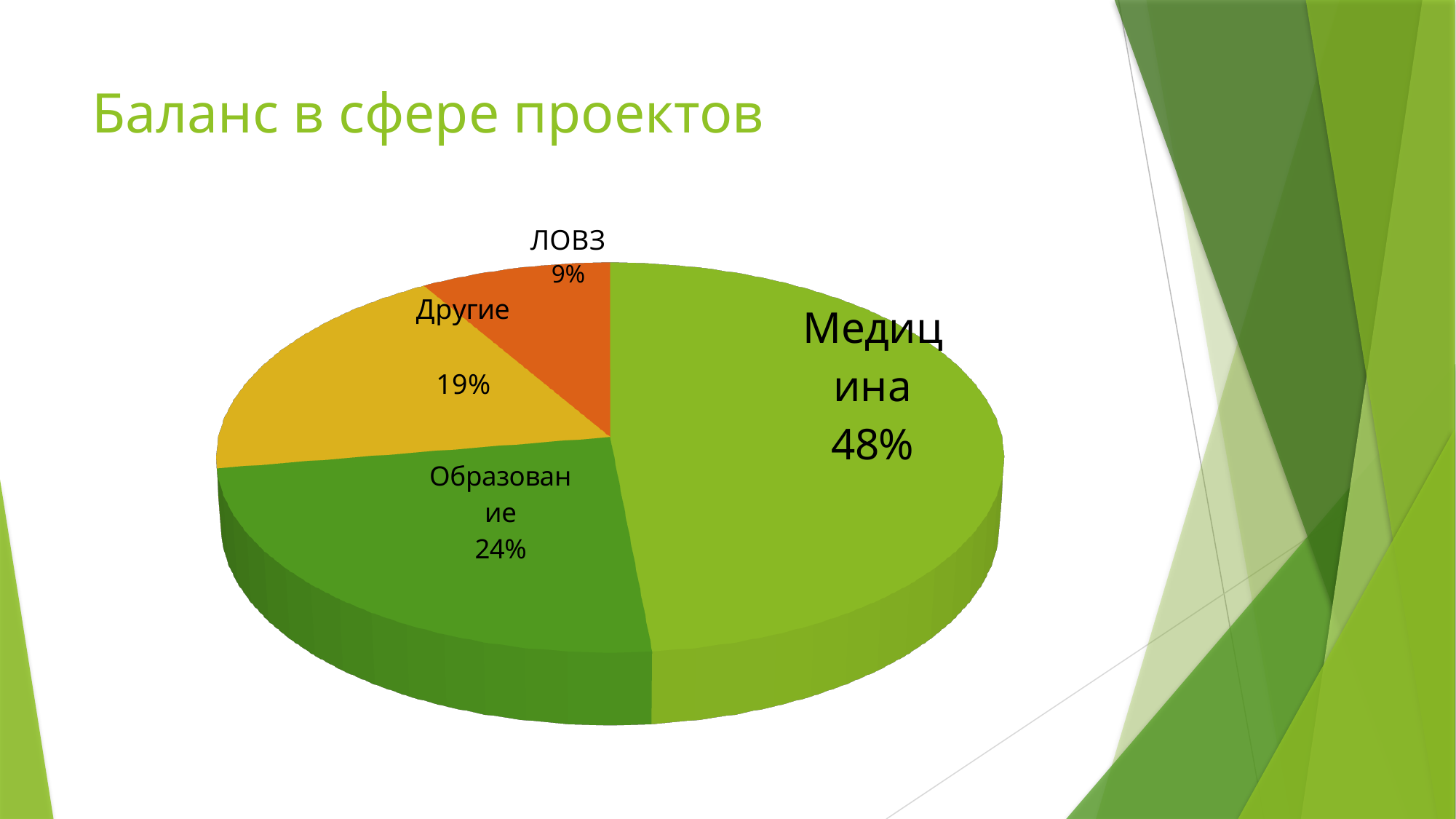
What share of the pie does Другие have? 19% What is the difference in percentage points between Другие and ЛОВЗ? 10 Which is larger, the share for Образование or the share for Другие? Образование What is the difference in percentage points between Медицина and Образование? 24 What share of the pie does Медицина have? 48% Which category has the smallest slice of the pie? ЛОВЗ What share of the pie does ЛОВЗ have? 9% How many slices does the pie chart have? 4 What is the title of the slide? Баланс в сфере проектов Which category has the largest slice of the pie? Медицина What kind of chart is shown on the slide? Pie chart